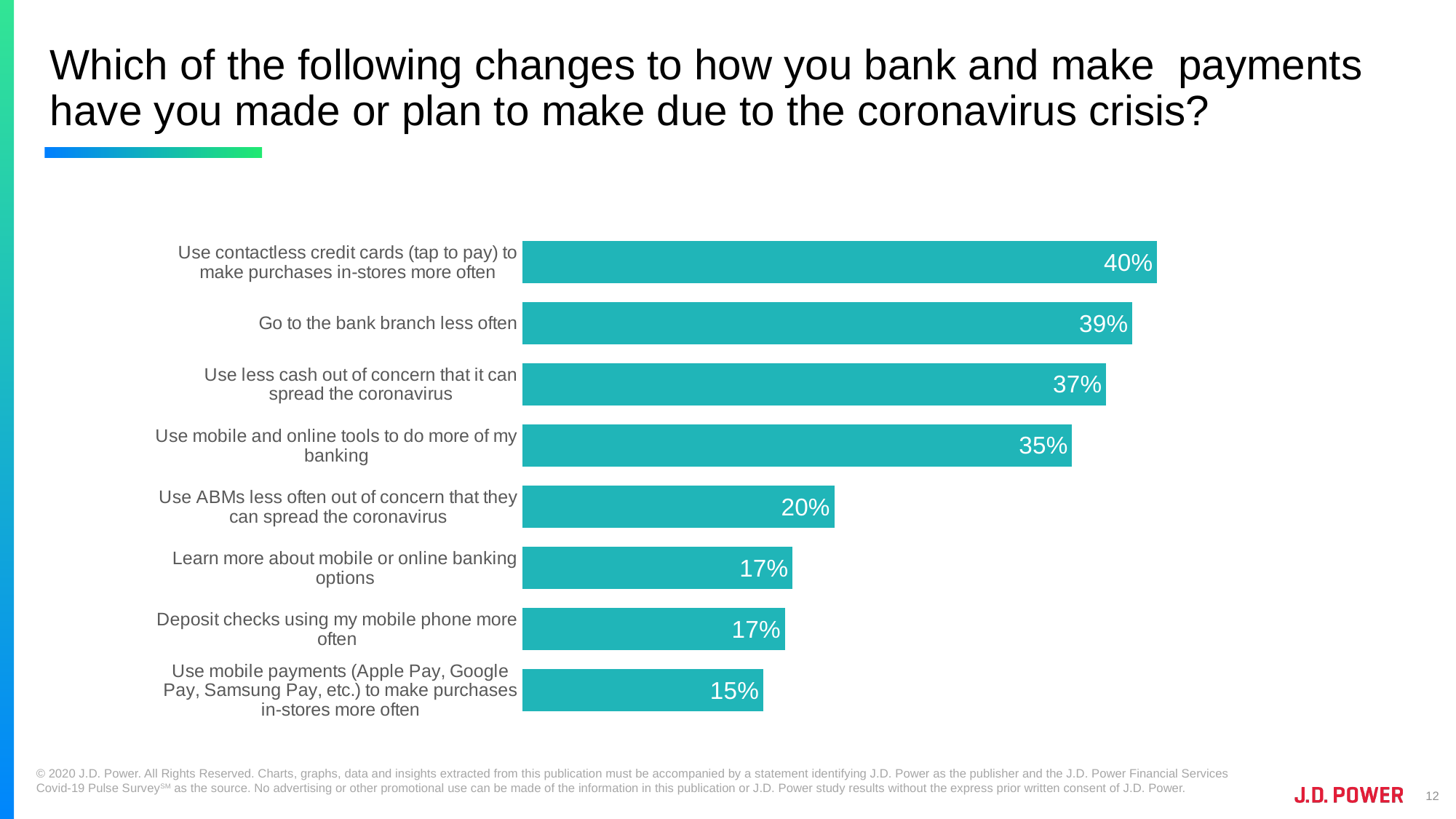
Which is larger: the value for 'Use mobile and online tools to do more of my banking' or the value for 'Use ABMs less often out of concern that they can spread the coronavirus'? Use mobile and online tools to do more of my banking Which change has the lowest percentage of respondents? Use mobile payments (Apple Pay, Google Pay, Samsung Pay, etc.) to make purchases in-stores more often What percentage said they would use ABMs less often out of concern that they can spread the coronavirus? 20% What is the difference in percentage points between 'Go to the bank branch less often' and 'Use less cash out of concern that it can spread the coronavirus'? 2 percentage points How many changes (categories) are shown on the chart? 8 Which two categories share the same value of 17%? Learn more about mobile or online banking options; Deposit checks using my mobile phone more often What type of chart is shown on the slide? Bar chart What percentage of respondents said they would use contactless credit cards (tap to pay) to make purchases in-stores more often? 40% What is the value for 'Use mobile and online tools to do more of my banking'? 35% Which change has the highest percentage of respondents? Use contactless credit cards (tap to pay) to make purchases in-stores more often What is the difference between the highest and lowest values on the chart? 25 percentage points What percentage of respondents said they would go to the bank branch less often? 39%